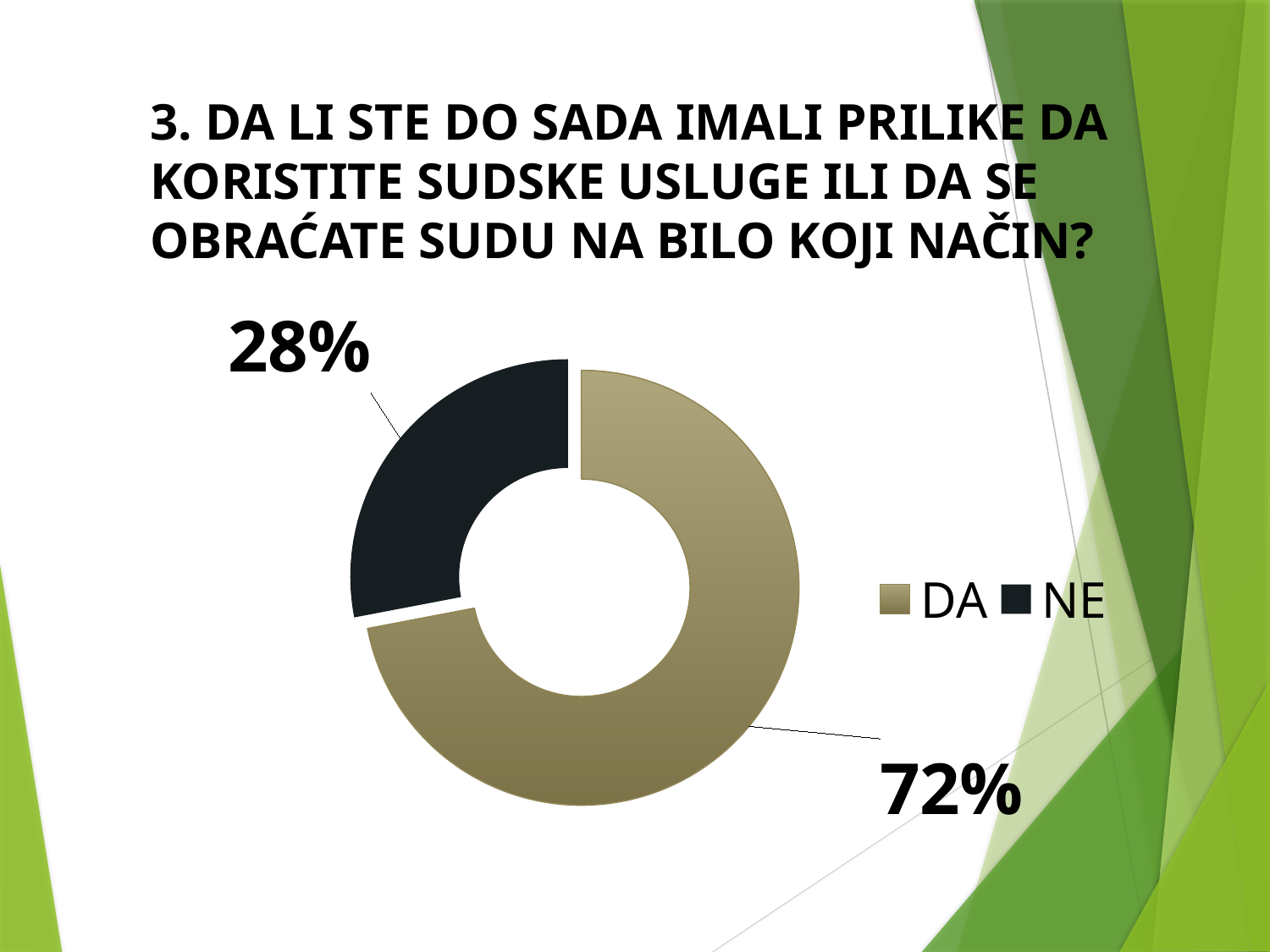
What is the difference in percentage points between DA and NE? 44 What percentage of respondents answered DA? 72% Which is larger, the share for DA or the share for NE? DA Which category has the largest share? DA What share of the chart does the DA slice represent? 72% Which colour represents NE in the chart? Black What percentage of respondents answered NE? 28% How many entries does the legend list? 2 Which category has the smallest share? NE How many categories does the chart show? 2 Is the share for NE greater or less than 50%? less What kind of chart is shown on the slide? Doughnut (pie) chart